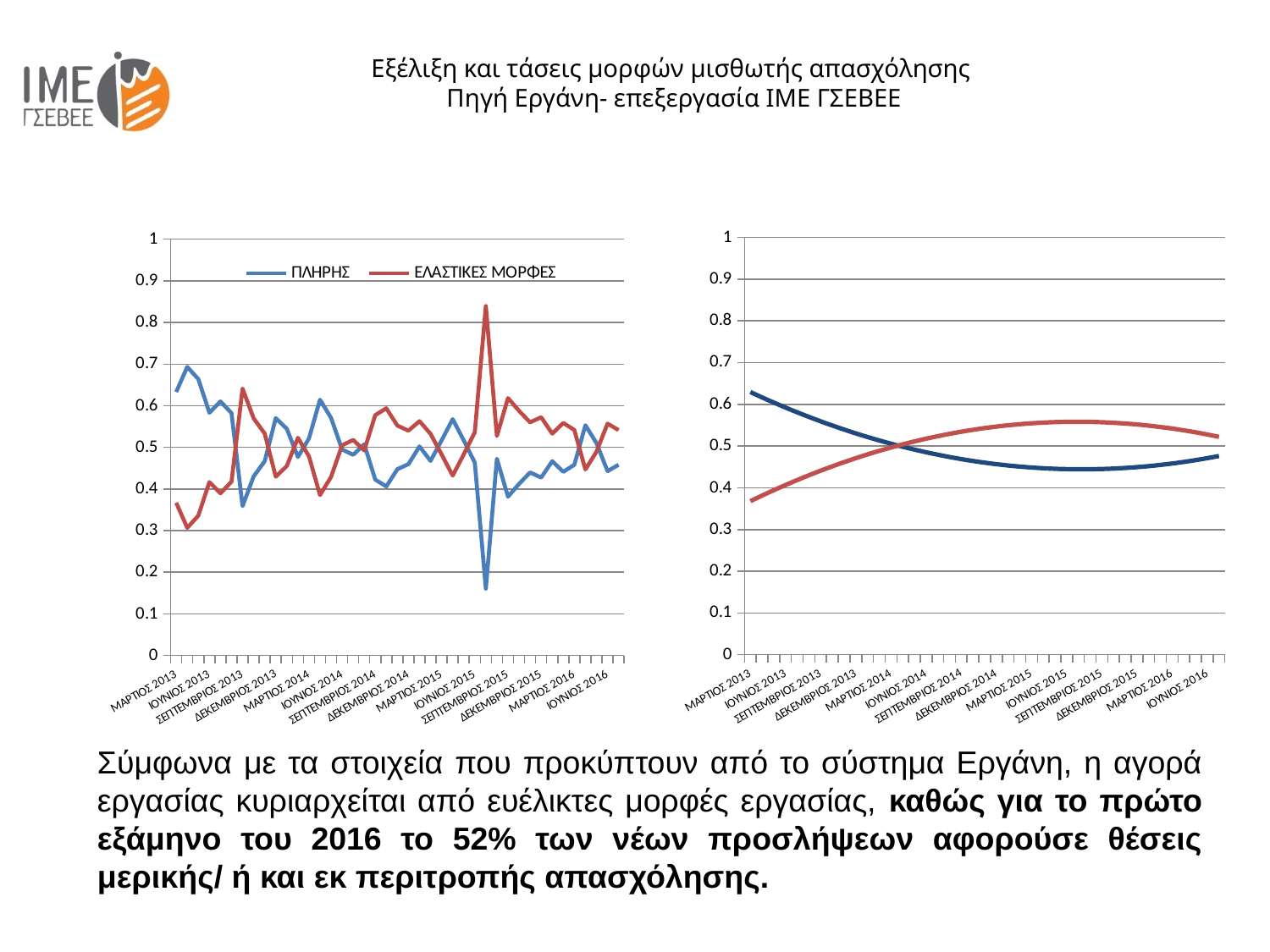
What are the two series named in the legend of the left chart? ΠΛΗΡΗΣ and ΕΛΑΣΤΙΚΕΣ ΜΟΡΦΕΣ In the left chart, does the ΠΛΗΡΗΣ line overall rise or fall from ΜΑΡΤΙΟΣ 2013 to ΙΟΥΝΙΟΣ 2016? fall What kind of chart is the left chart? line chart In the left chart, which series has the higher value at ΜΑΡΤΙΟΣ 2013? ΠΛΗΡΗΣ In the left chart, is the value of ΕΛΑΣΤΙΚΕΣ ΜΟΡΦΕΣ at ΜΑΡΤΙΟΣ 2013 greater or less than 0.5? less In the left chart, is the value of ΠΛΗΡΗΣ at ΜΑΡΤΙΟΣ 2013 greater or less than 0.5? greater What is the maximum value shown on the y axis of the right chart? 1 In the left chart, is the highest point of the ΕΛΑΣΤΙΚΕΣ ΜΟΡΦΕΣ line greater or less than 0.8? greater How many series does the legend of the left chart list? 2 In the right chart, which line is higher at ΙΟΥΝΙΟΣ 2016, the red line or the dark blue line? the red line